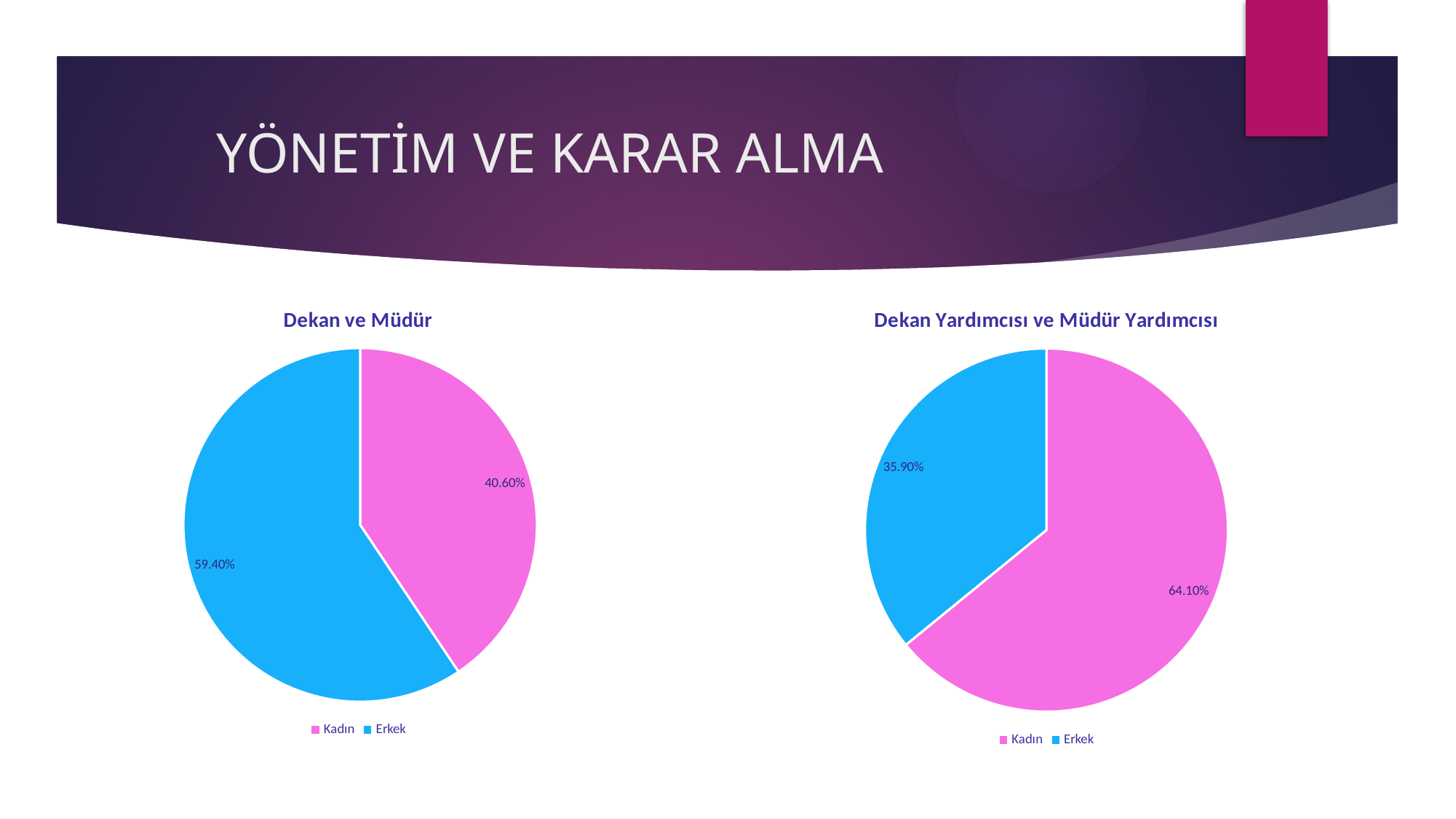
What type of chart is the 'Dekan ve Müdür' chart? Pie chart In the 'Dekan Yardımcısı ve Müdür Yardımcısı' chart, what is the difference between the Kadın and Erkek shares? 28.20% In the 'Dekan Yardımcısı ve Müdür Yardımcısı' chart, what is the value for Erkek? 35.90% In the 'Dekan ve Müdür' chart, which colour represents Kadın? Pink In the 'Dekan ve Müdür' chart, what is the difference between the Erkek and Kadın shares? 18.80% In the 'Dekan ve Müdür' chart, which category has the largest share? Erkek Is the Kadın share larger in the 'Dekan ve Müdür' chart or in the 'Dekan Yardımcısı ve Müdür Yardımcısı' chart? Dekan Yardımcısı ve Müdür Yardımcısı How many categories does the 'Dekan Yardımcısı ve Müdür Yardımcısı' chart show? 2 In the 'Dekan Yardımcısı ve Müdür Yardımcısı' chart, what is the value for Kadın? 64.10% In the 'Dekan ve Müdür' chart, what is the value for Erkek? 59.40% In the 'Dekan ve Müdür' chart, what is the value for Kadın? 40.60% In the 'Dekan Yardımcısı ve Müdür Yardımcısı' chart, which category has the smallest share? Erkek